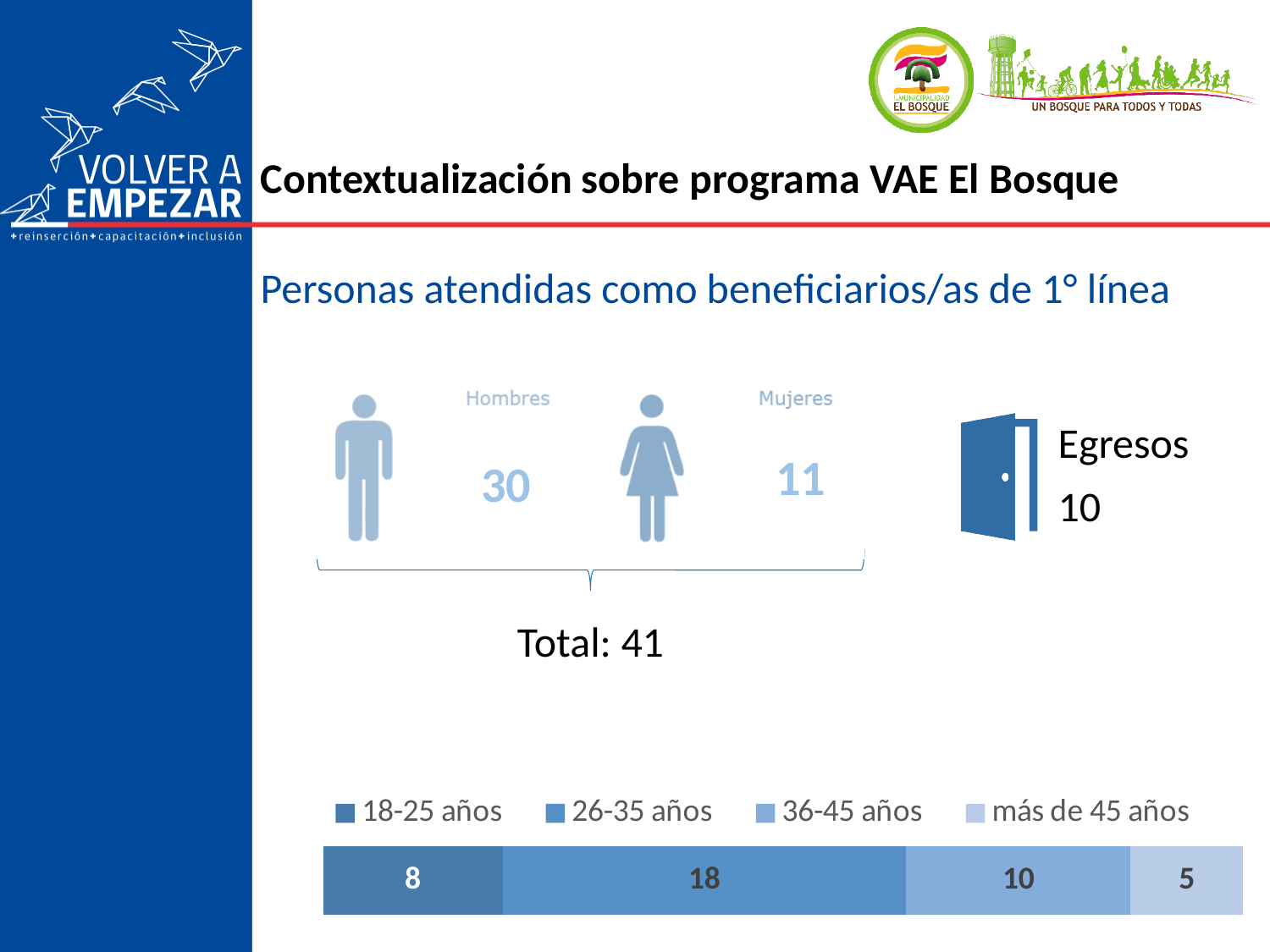
In the stacked bar chart at the bottom of the slide, what is the value for the 18-25 años segment? 8 In the stacked bar chart at the bottom of the slide, what is the difference between the 26-35 años and 36-45 años segments? 8 In the stacked bar chart at the bottom of the slide, which is larger: the 18-25 años segment or the 36-45 años segment? 36-45 años What kind of chart is shown at the bottom of the slide? Stacked bar chart In the stacked bar chart at the bottom of the slide, what is the value for the 26-35 años segment? 18 In the pictogram in the middle of the slide, what is the value shown for Hombres? 30 In the stacked bar chart at the bottom of the slide, what is the value for the 36-45 años segment? 10 In the stacked bar chart at the bottom of the slide, which age group has the lowest value? más de 45 años How many series does the legend of the stacked bar chart at the bottom of the slide list? 4 In the stacked bar chart at the bottom of the slide, what is the value for the más de 45 años segment? 5 In the stacked bar chart at the bottom of the slide, which age group has the highest value? 26-35 años In the stacked bar chart at the bottom of the slide, what is the total of all segments in the bar? 41